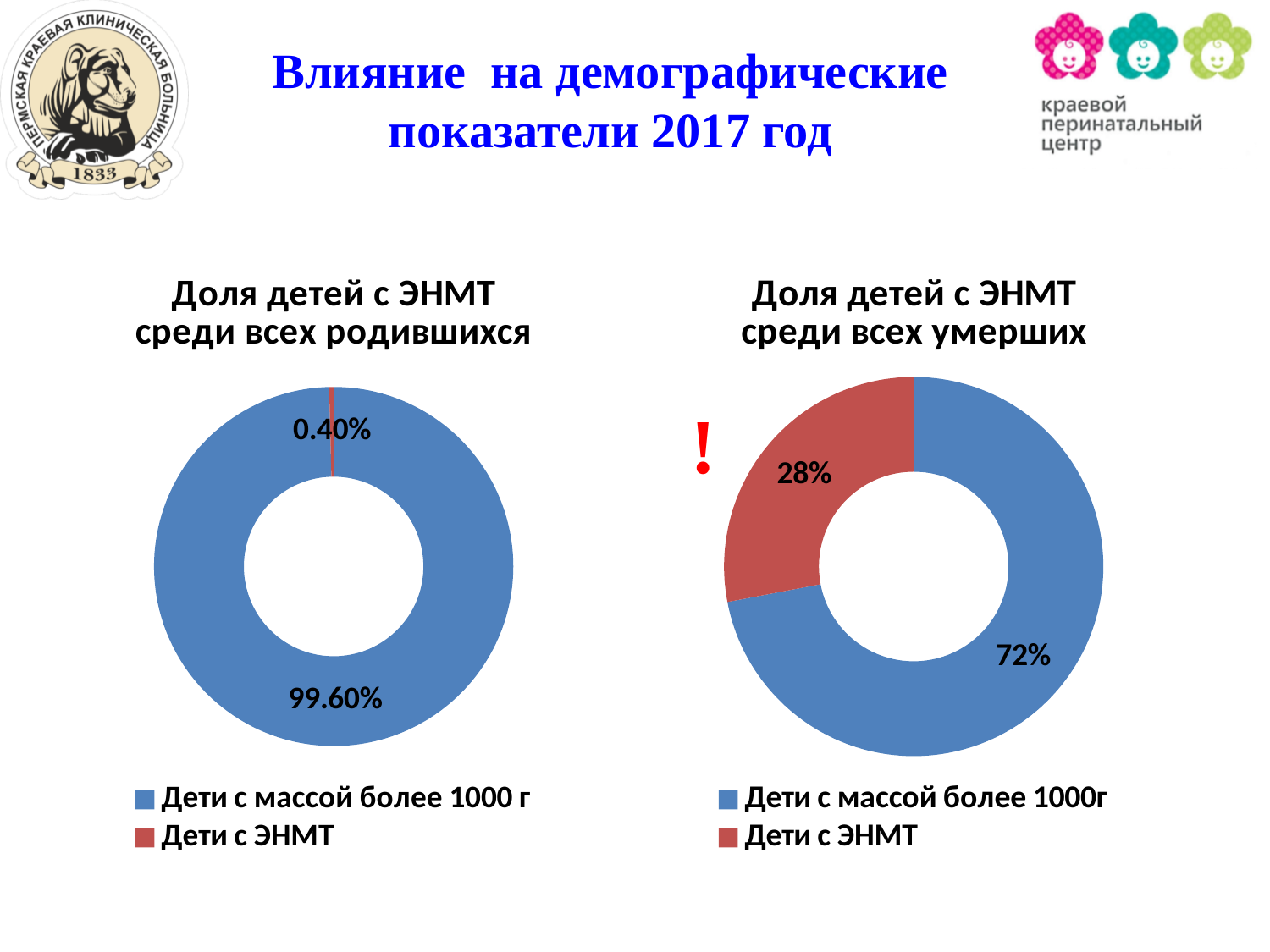
How many categories does the chart titled "Доля детей с ЭНМТ среди всех умерших" show? 2 In the chart titled "Доля детей с ЭНМТ среди всех умерших", what is the value for "Дети с ЭНМТ"? 28% Which is larger: the share of "Дети с ЭНМТ" in the left chart (среди всех родившихся) or in the right chart (среди всех умерших)? The right chart (среди всех умерших) In the chart titled "Доля детей с ЭНМТ среди всех родившихся", what is the value for "Дети с массой более 1000 г"? 99.60% In the chart titled "Доля детей с ЭНМТ среди всех умерших", what is the difference between the shares of "Дети с массой более 1000г" and "Дети с ЭНМТ"? 44% In the chart titled "Доля детей с ЭНМТ среди всех умерших", what is the value for "Дети с массой более 1000г"? 72% In the chart titled "Доля детей с ЭНМТ среди всех умерших", what colour represents "Дети с ЭНМТ"? Red In the chart titled "Доля детей с ЭНМТ среди всех умерших", which category has the largest share? Дети с массой более 1000г In the chart titled "Доля детей с ЭНМТ среди всех родившихся", what is the value for "Дети с ЭНМТ"? 0.40% What type of chart is the chart titled "Доля детей с ЭНМТ среди всех родившихся"? Doughnut (pie) chart In the chart titled "Доля детей с ЭНМТ среди всех родившихся", what is the difference between the shares of "Дети с массой более 1000 г" and "Дети с ЭНМТ"? 99.20% In the chart titled "Доля детей с ЭНМТ среди всех родившихся", which category has the smallest share? Дети с ЭНМТ